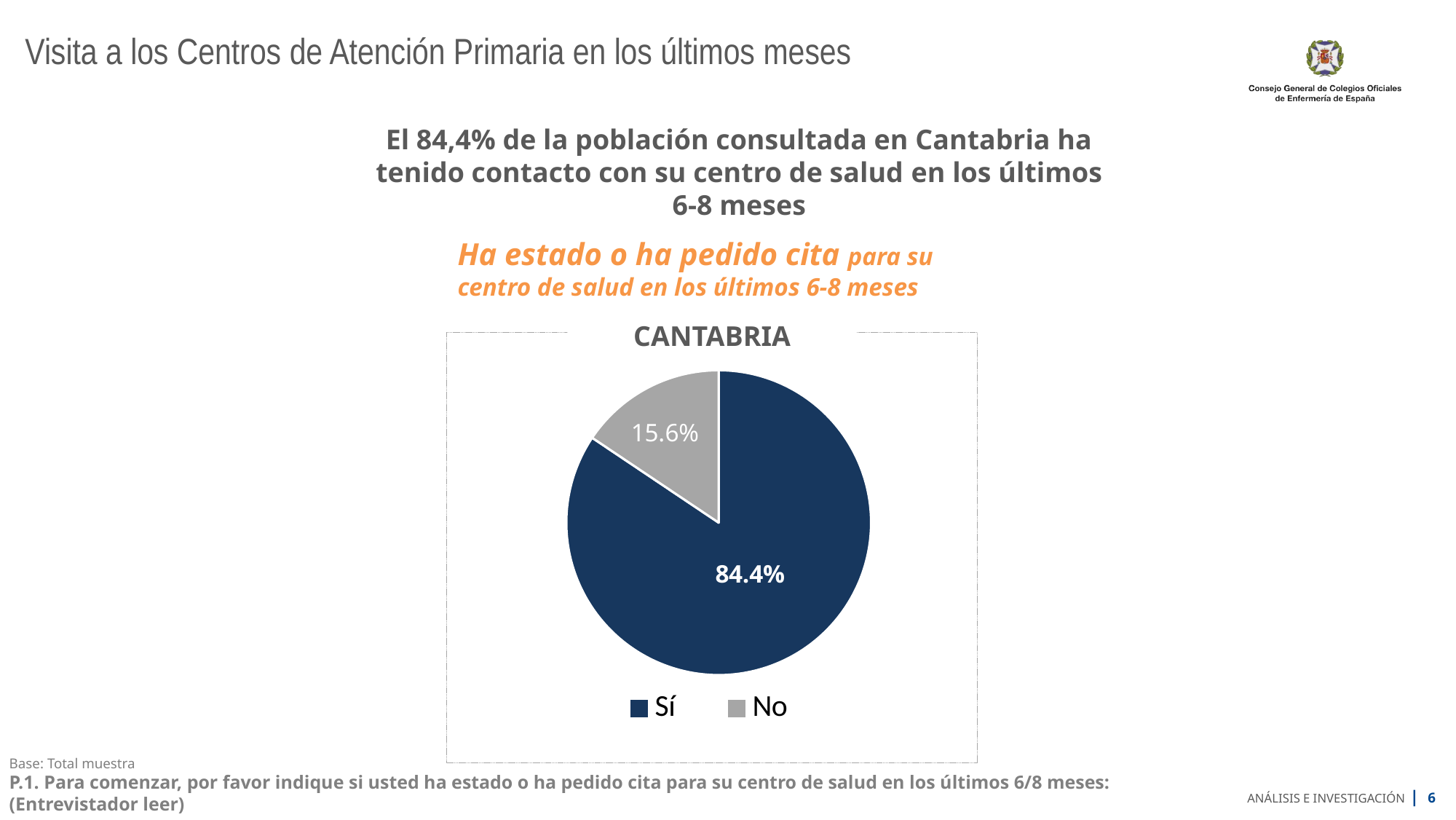
What is the difference in percentage points between the "Sí" and "No" slices? 68.8 What type of chart is shown on the slide? Pie chart How many entries does the legend of the pie chart list? 2 Which slice of the pie chart is the smallest? No What is the title of the pie chart? CANTABRIA What share of the pie does the "No" slice represent? 15.6% Which slice of the pie chart is the largest? Sí What colour is the "Sí" slice in the pie chart? Dark blue How many slices does the pie chart have? 2 What percentage of the pie chart corresponds to "No"? 15.6% Which is larger, the "Sí" slice or the "No" slice? Sí What percentage of the pie chart corresponds to "Sí"? 84.4%